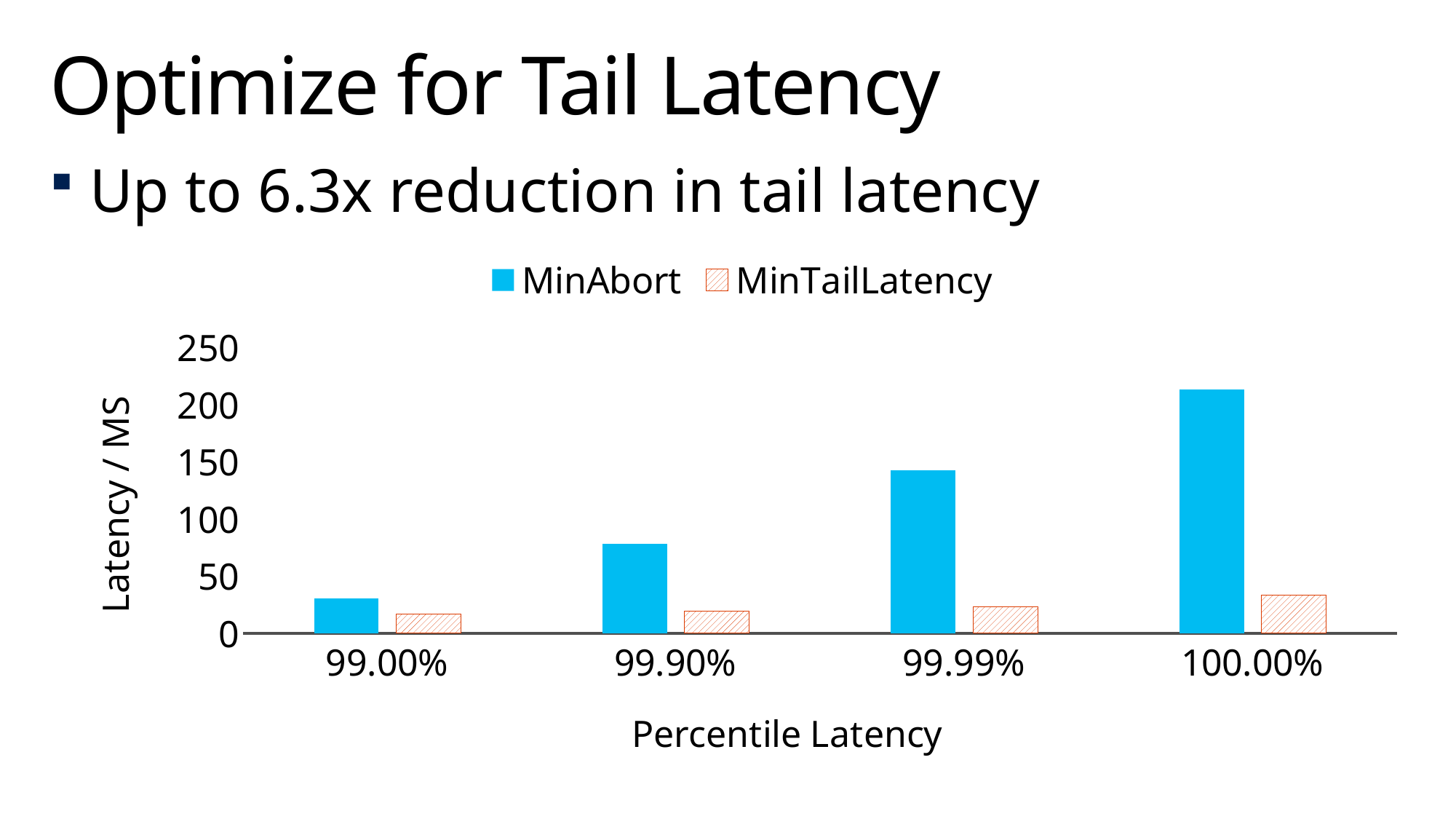
Which series has the highest bar at 100.00%? MinAbort Is the MinTailLatency value at 100.00% greater or less than 50? less What kind of chart is shown on the slide? bar chart At which percentile is the MinAbort bar the lowest? 99.00% How many percentile categories are shown on the x axis? 4 Is the MinAbort value at 99.90% greater or less than 100? less Which is larger at 99.99%, MinAbort or MinTailLatency? MinAbort Is the MinAbort value at 100.00% greater or less than 200? greater Do the MinAbort values rise or fall as the percentile increases along the x axis? rise At which percentile is the MinAbort bar the highest? 100.00% What is the label of the y axis? Latency / MS How many series does the legend list? 2